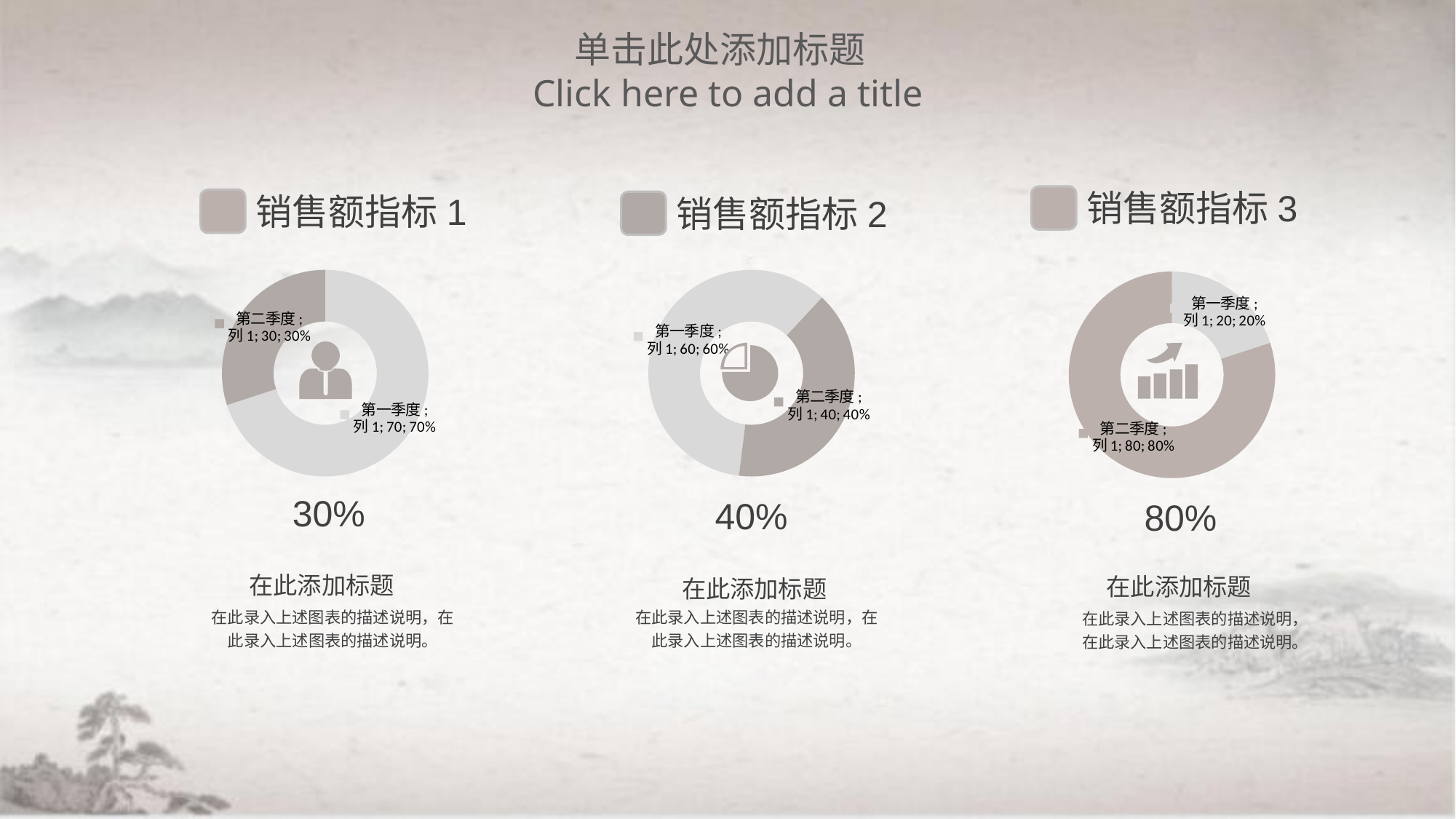
How many categories does the 销售额指标 1 chart show? 2 In the 销售额指标 3 chart, what is the value for 第二季度? 80 In the 销售额指标 2 chart, what is the value for 第一季度? 60 In the 销售额指标 2 chart, what is the difference between the 第一季度 and 第二季度 values? 20 In the 销售额指标 1 chart, which category has the largest slice? 第一季度 What kind of chart is used for 销售额指标 2? doughnut chart In the 销售额指标 3 chart, which category has the smallest slice? 第一季度 In the 销售额指标 2 chart, what share does 第二季度 take? 40% In the 销售额指标 3 chart, what share does 第一季度 take? 20% In the 销售额指标 3 chart, which is larger, 第一季度 or 第二季度? 第二季度 In the 销售额指标 1 chart, what is the value for 第二季度? 30 In the 销售额指标 1 chart, what share of the doughnut does 第一季度 take? 70%